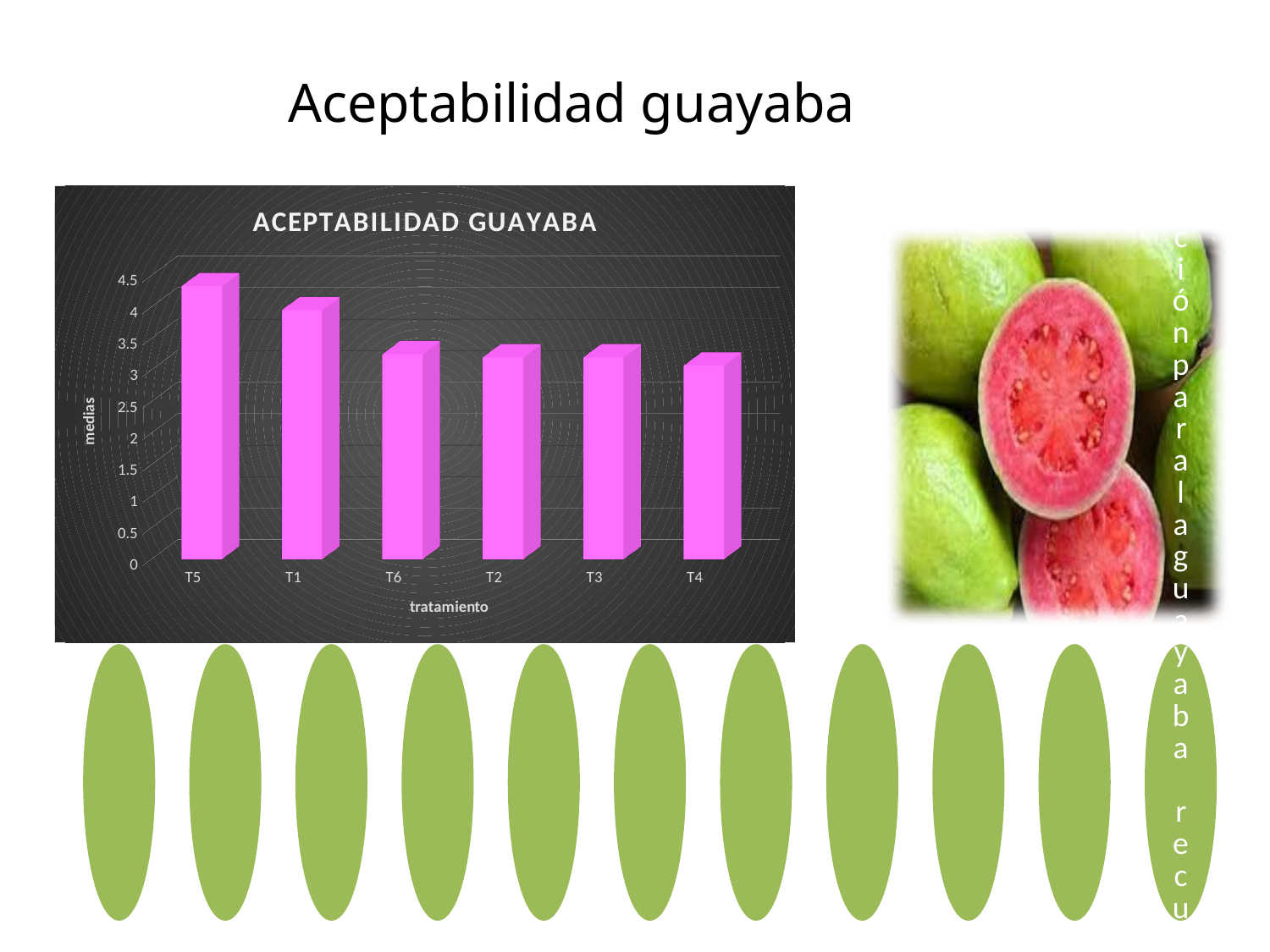
Which is larger, the value for T1 or the value for T6? T1 How many treatments (categories) are plotted on the x axis? 6 Is the value for T1 greater or less than 3.5? greater Is the value for T4 greater or less than 3.5? less Which is larger, the value for T5 or the value for T1? T5 Is the value for T2 greater or less than 3? greater What kind of chart is shown on the slide? Bar chart What is the label of the vertical axis? medias Which treatment has the highest mean acceptability? T5 Do the values rise or fall from left to right along the x axis? fall